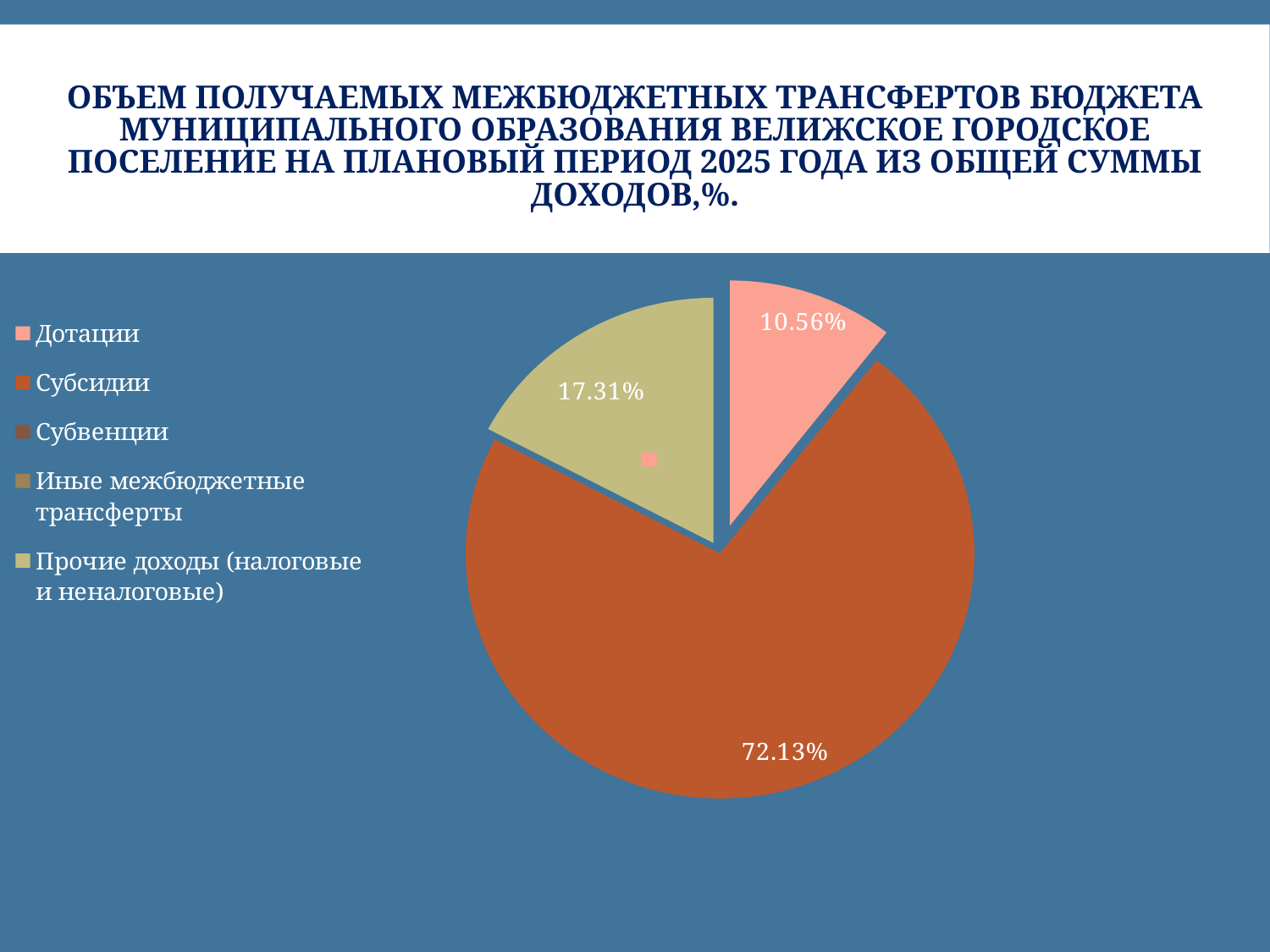
How many entries does the legend list? 5 What type of chart is shown on the slide? pie chart What share of the pie does Дотации have? 10.56% What colour is the Дотации slice in the pie chart? pink What is the difference in percentage points between the slice labelled 17.31% and the Дотации slice? 6.75 Which is larger, the slice for Дотации or the slice for Субсидии? Субсидии Which planning year is named in the chart title? 2025 What share of the pie does Субсидии have? 72.13% Which category has the largest slice of the pie? Субсидии What is the difference in percentage points between the Субсидии slice and the Дотации slice? 61.57 How many slices of the pie have a percentage label printed on them? 3